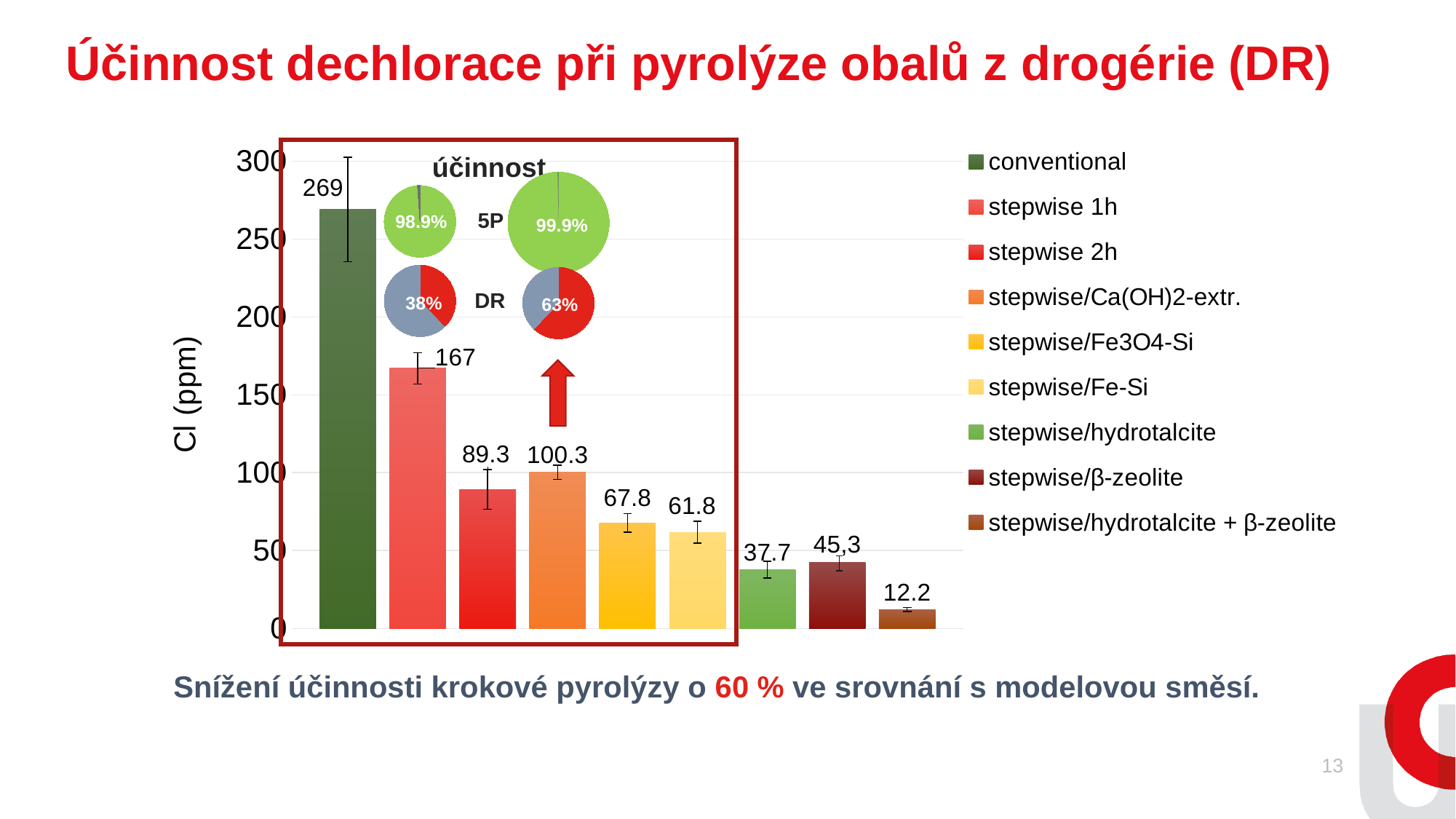
What is the Cl (ppm) value for the conventional bar? 269 Is the value for stepwise/hydrotalcite greater or less than 50? less What is the difference in Cl (ppm) between conventional and stepwise 1h? 102 What is the Cl (ppm) value for stepwise/β-zeolite? 45.3 How many entries does the legend list? 9 What is the Cl (ppm) value for stepwise/Fe-Si? 61.8 Which bar has the lowest Cl (ppm) value? stepwise/hydrotalcite + β-zeolite Which bar has the highest Cl (ppm) value? conventional How many bars are plotted in the bar chart? 9 What is the label of the vertical axis? Cl (ppm) Which has a higher Cl (ppm) value, stepwise 2h or stepwise/Ca(OH)2-extr.? stepwise/Ca(OH)2-extr. What is the Cl (ppm) value for stepwise/Ca(OH)2-extr.? 100.3